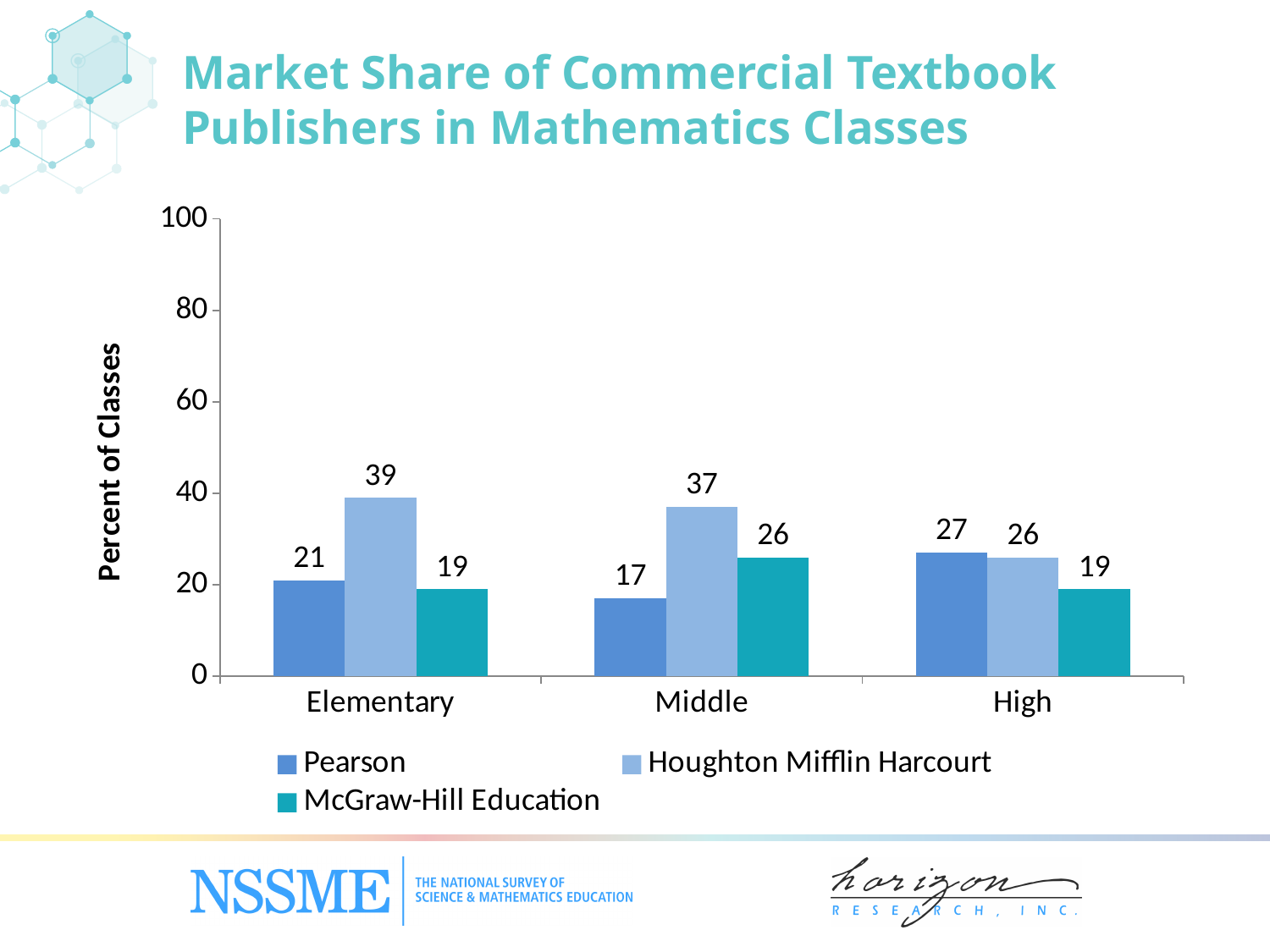
Which is larger in High: Pearson or McGraw-Hill Education? Pearson Is the value for Houghton Mifflin Harcourt in Middle greater or less than 20? greater Which publisher has the lowest value in the High category? McGraw-Hill Education What kind of chart is shown on the slide? bar chart What is the value for McGraw-Hill Education in High? 19 How many categories are shown on the x axis? 3 What is the label of the y axis? Percent of Classes What is the value for Pearson in Middle? 17 Which publisher has the highest value in the Middle category? Houghton Mifflin Harcourt What is the difference between Houghton Mifflin Harcourt and Pearson in Elementary? 18 How many series does the legend list? 3 What is the value for Houghton Mifflin Harcourt in Elementary? 39